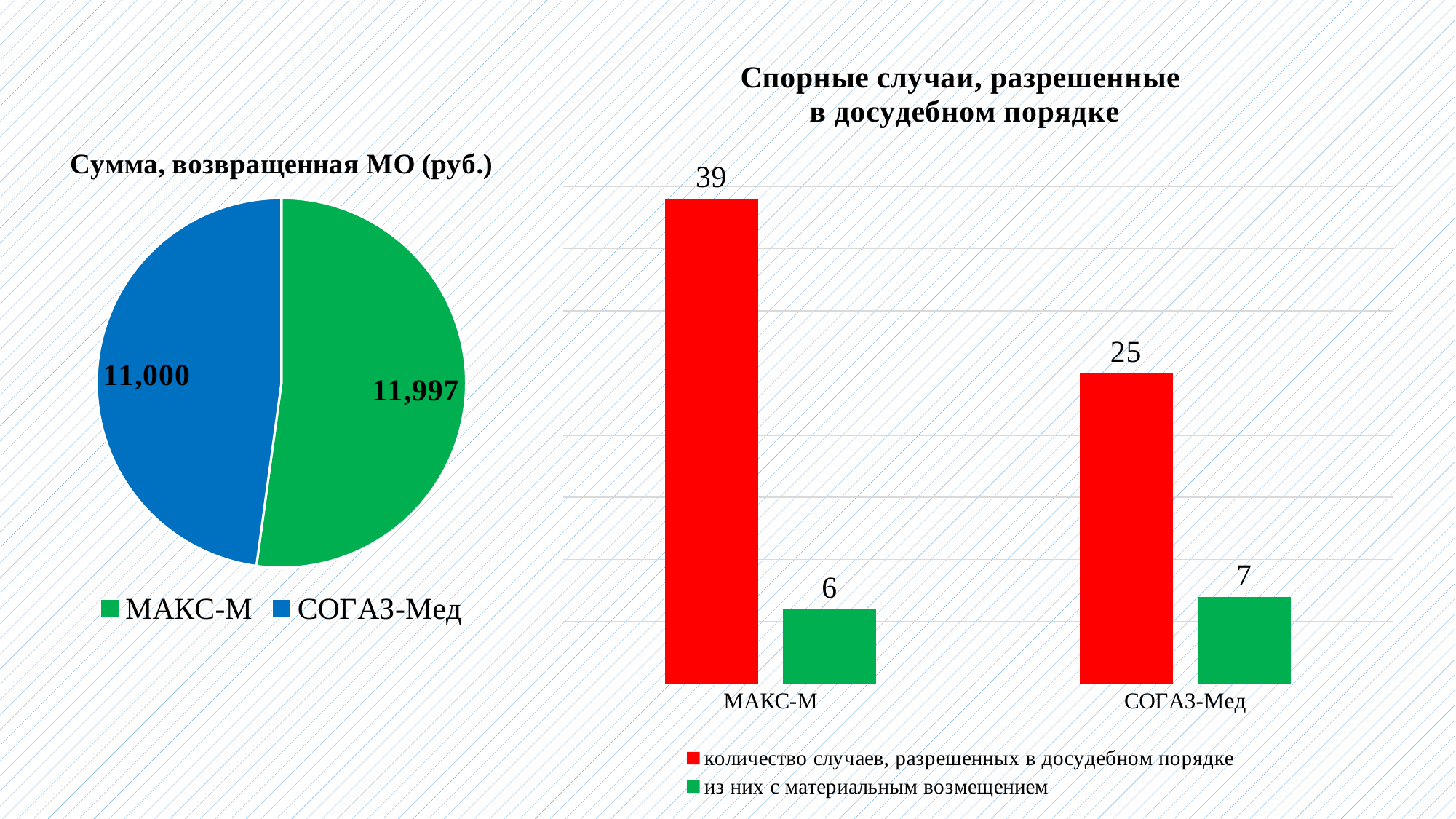
In the bar chart 'Спорные случаи, разрешенные в досудебном порядке', which category has the higher value of 'из них с материальным возмещением'? СОГАЗ-Мед In the bar chart 'Спорные случаи, разрешенные в досудебном порядке', what is the difference between the 'количество случаев, разрешенных в досудебном порядке' values for МАКС-М and СОГАЗ-Мед? 14 In the pie chart 'Сумма, возвращенная МО (руб.)', how many slices are there? 2 In the pie chart 'Сумма, возвращенная МО (руб.)', what is the value for СОГАЗ-Мед? 11,000 In the pie chart 'Сумма, возвращенная МО (руб.)', what is the difference between the МАКС-М and СОГАЗ-Мед values? 997 What is the title of the chart on the left side of the slide? Сумма, возвращенная МО (руб.) In the bar chart 'Спорные случаи, разрешенные в досудебном порядке', what is the value of 'из них с материальным возмещением' for СОГАЗ-Мед? 7 In the pie chart 'Сумма, возвращенная МО (руб.)', what is the value for МАКС-М? 11,997 In the bar chart 'Спорные случаи, разрешенные в досудебном порядке', what is the value of 'количество случаев, разрешенных в досудебном порядке' for МАКС-М? 39 In the pie chart 'Сумма, возвращенная МО (руб.)', which category has the larger value? МАКС-М What kind of chart is the chart on the right side of the slide? Bar chart In the bar chart 'Спорные случаи, разрешенные в досудебном порядке', how many series does the legend list? 2